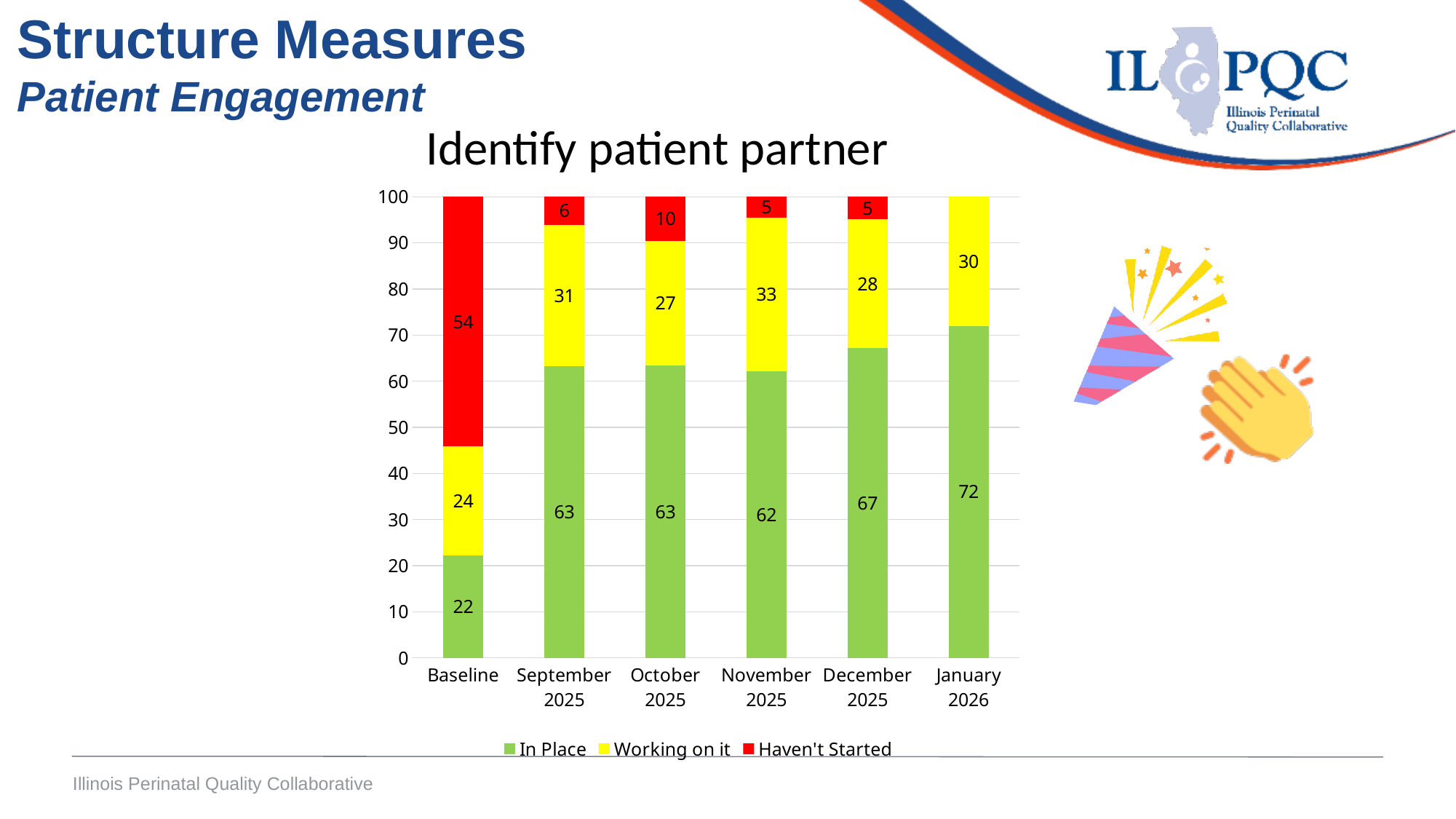
Which is larger, the Haven't Started value for October 2025 or for September 2025? October 2025 What is the In Place value for January 2026? 72 How many categories are shown on the x axis? 6 What is the Haven't Started value for Baseline? 54 What is the difference between the In Place values for January 2026 and Baseline? 50 What is the Working on it value for November 2025? 33 Which category has the highest In Place value? January 2026 What is the title of the chart? Identify patient partner Which category has the lowest In Place value? Baseline How many series does the legend list? 3 What is the total of the stacked bar for December 2025? 100 What kind of chart is shown? Stacked bar chart